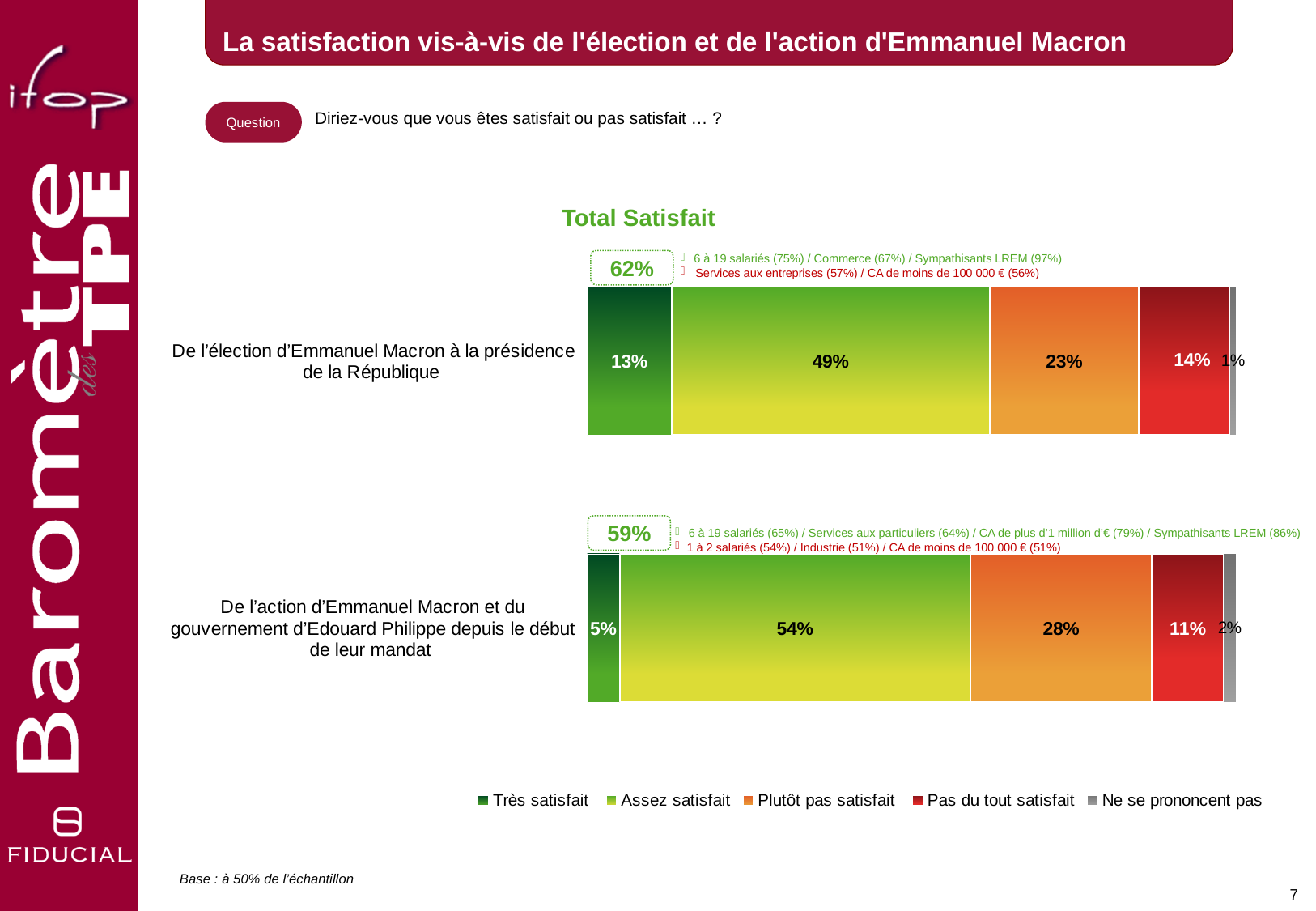
What is the "Plutôt pas satisfait" value for the action of Emmanuel Macron and the government? 28% What percentage of respondents are "Assez satisfait" with the election of Emmanuel Macron to the presidency? 49% What kind of chart is shown on the slide? Stacked bar chart What is the "Total Satisfait" figure shown for the action of Emmanuel Macron and the government? 59% How many series does the legend list? 5 Which is larger: the "Plutôt pas satisfait" value for the election or for the action of the government? Action of the government Which response category has the lowest value for the election of Emmanuel Macron to the presidency? Ne se prononcent pas What is the "Pas du tout satisfait" value for the election of Emmanuel Macron to the presidency? 14% What is the "Total Satisfait" figure shown for the election of Emmanuel Macron to the presidency? 62% What percentage of respondents are "Très satisfait" with the action of Emmanuel Macron and the Edouard Philippe government? 5% Which response category has the highest value for the action of Emmanuel Macron and the government? Assez satisfait What is the difference between the "Assez satisfait" values for the action of the government (54%) and the election (49%)? 5 points